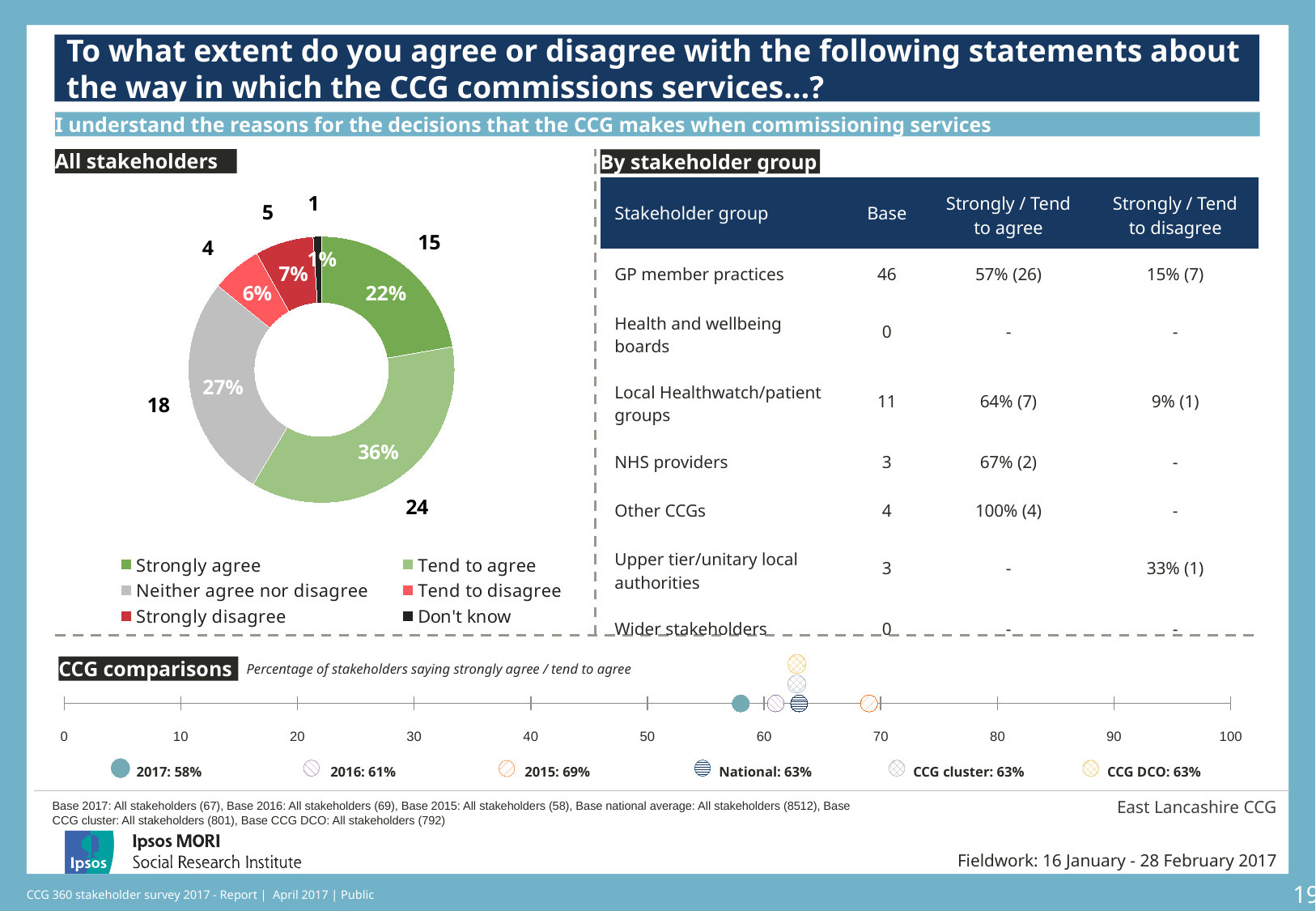
How many response categories does the legend of the All stakeholders donut chart list? 6 In the CCG comparisons chart, what is the difference in percentage points between the 2015 and 2017 values? 11 In the All stakeholders donut chart, what percentage of stakeholders tend to agree? 36% In the All stakeholders donut chart, which is larger: the share for Strongly disagree or the share for Tend to disagree? Strongly disagree In the All stakeholders donut chart, what is the difference in percentage points between Tend to agree and Strongly agree? 14 In the All stakeholders donut chart, how many stakeholders neither agree nor disagree? 18 In the All stakeholders donut chart, what percentage of stakeholders strongly agree? 22% In the All stakeholders donut chart, which response category has the smallest share? Don't know What type of chart is used for the All stakeholders section? Donut chart In the CCG comparisons chart, which year has the highest percentage of stakeholders agreeing? 2015 In the CCG comparisons chart, what percentage of stakeholders said strongly agree / tend to agree in 2017? 58% In the All stakeholders donut chart, which response category has the largest share? Tend to agree